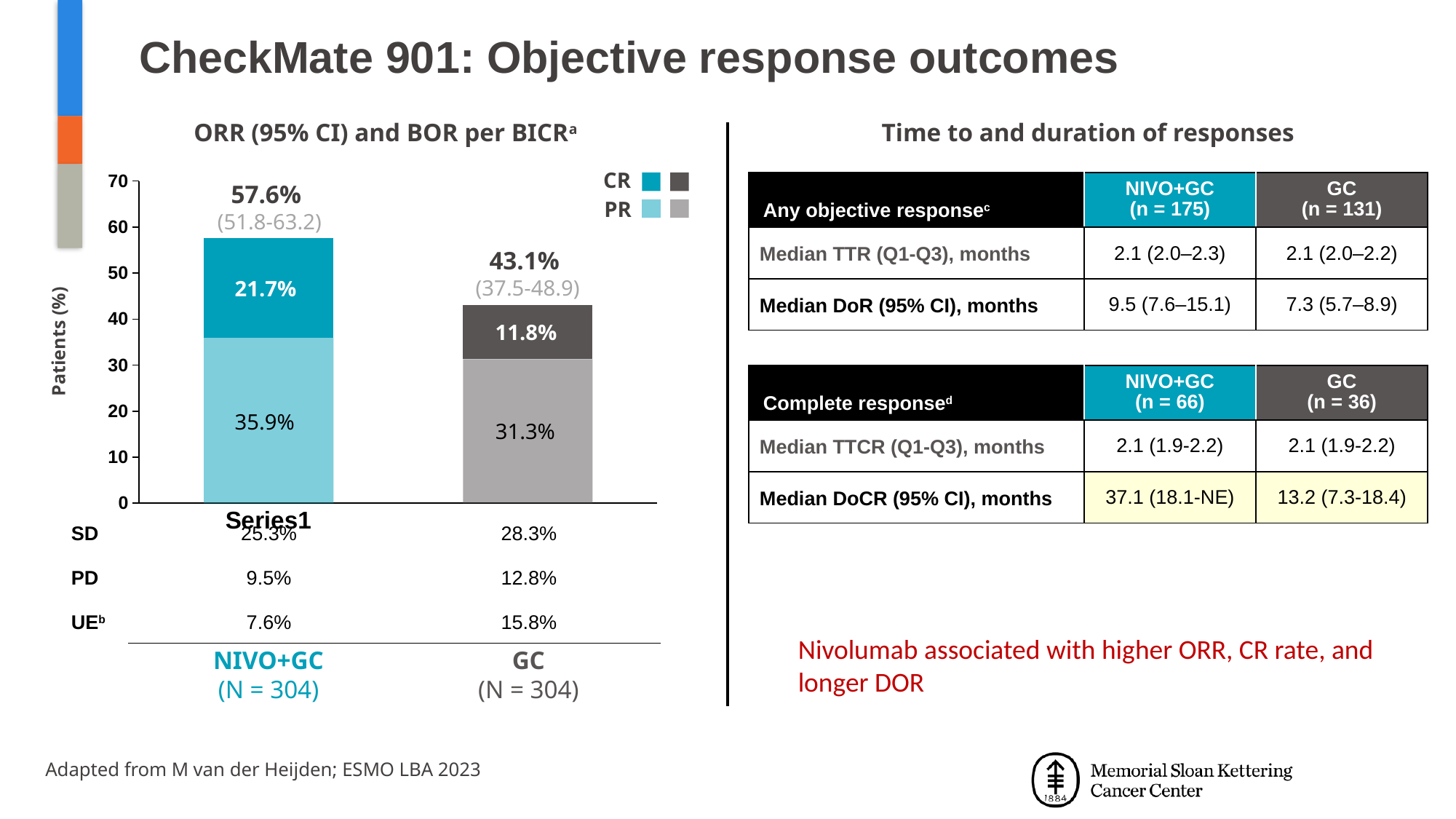
What is the total ORR shown above the NIVO+GC bar? 57.6% What is the label of the y axis of the bar chart? Patients (%) What is the CR value for GC in the bar chart? 11.8% What is the difference between the CR values for NIVO+GC and GC? 9.9% What is the PR value for NIVO+GC in the bar chart? 35.9% How many series does the legend of the bar chart list? 2 Which treatment arm has the higher CR value in the bar chart? NIVO+GC Is the PR value for NIVO+GC larger or smaller than the PR value for GC? larger What is the PR value for GC in the bar chart? 31.3% What is the total ORR shown above the GC bar? 43.1% What is the CR value for NIVO+GC in the bar chart? 21.7% What kind of chart is shown on the left of the slide? stacked bar chart